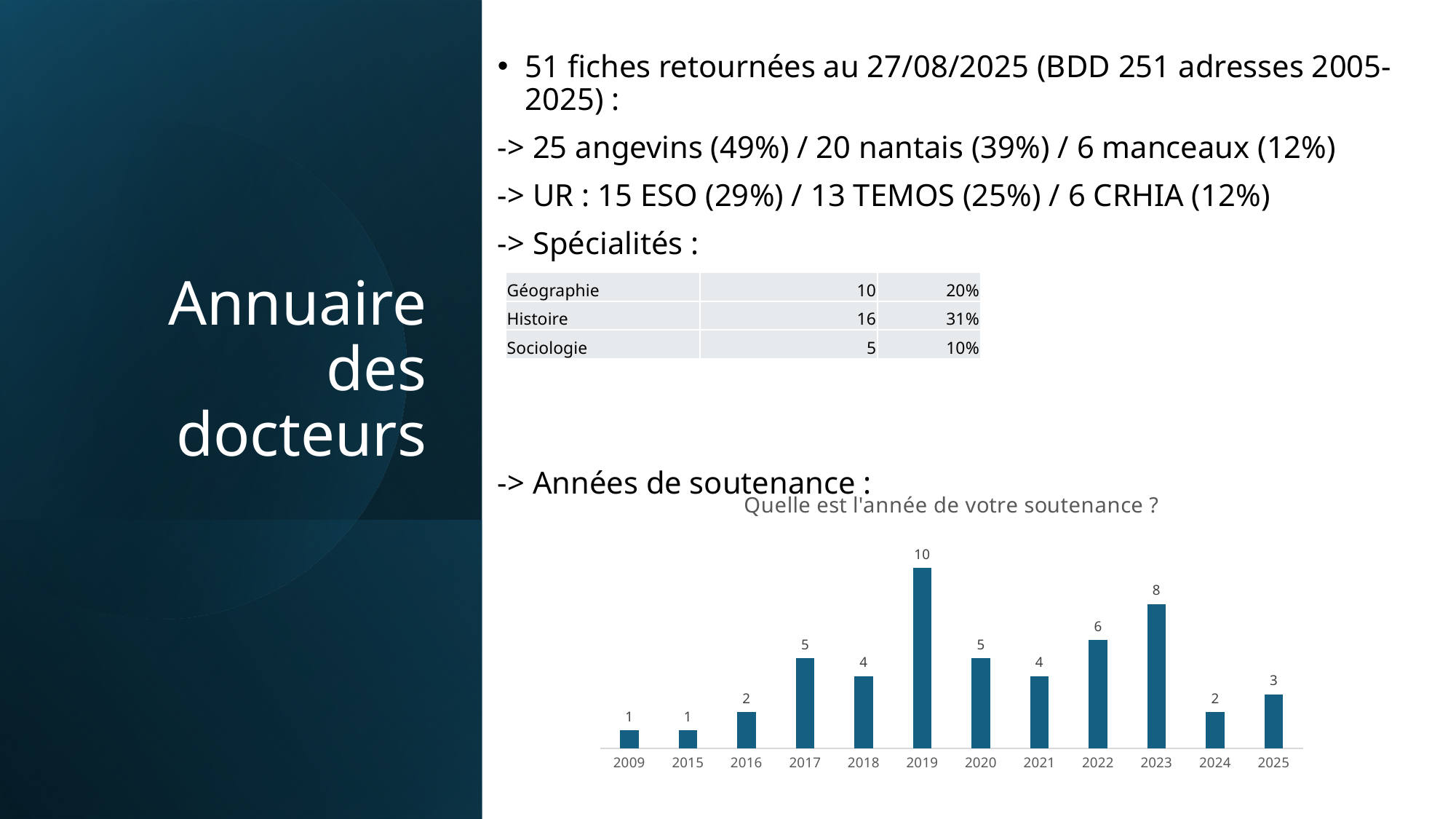
What is the value for 2023 in the chart? 8 What is the value for 2019 in the chart? 10 What is the value for 2024 in the chart? 2 Do the values rise or fall from 2023 to 2024 in the chart? fall Which year has the highest value in the chart? 2019 What is the title of the chart? Quelle est l'année de votre soutenance ? What is the difference between the values for 2019 and 2023? 2 How many years are shown on the x axis of the chart? 12 Which is larger, the value for 2020 or the value for 2022? 2022 What kind of chart is shown on the slide? bar chart What is the difference between the values for 2022 and 2025? 3 Which is larger, the value for 2017 or the value for 2018? 2017